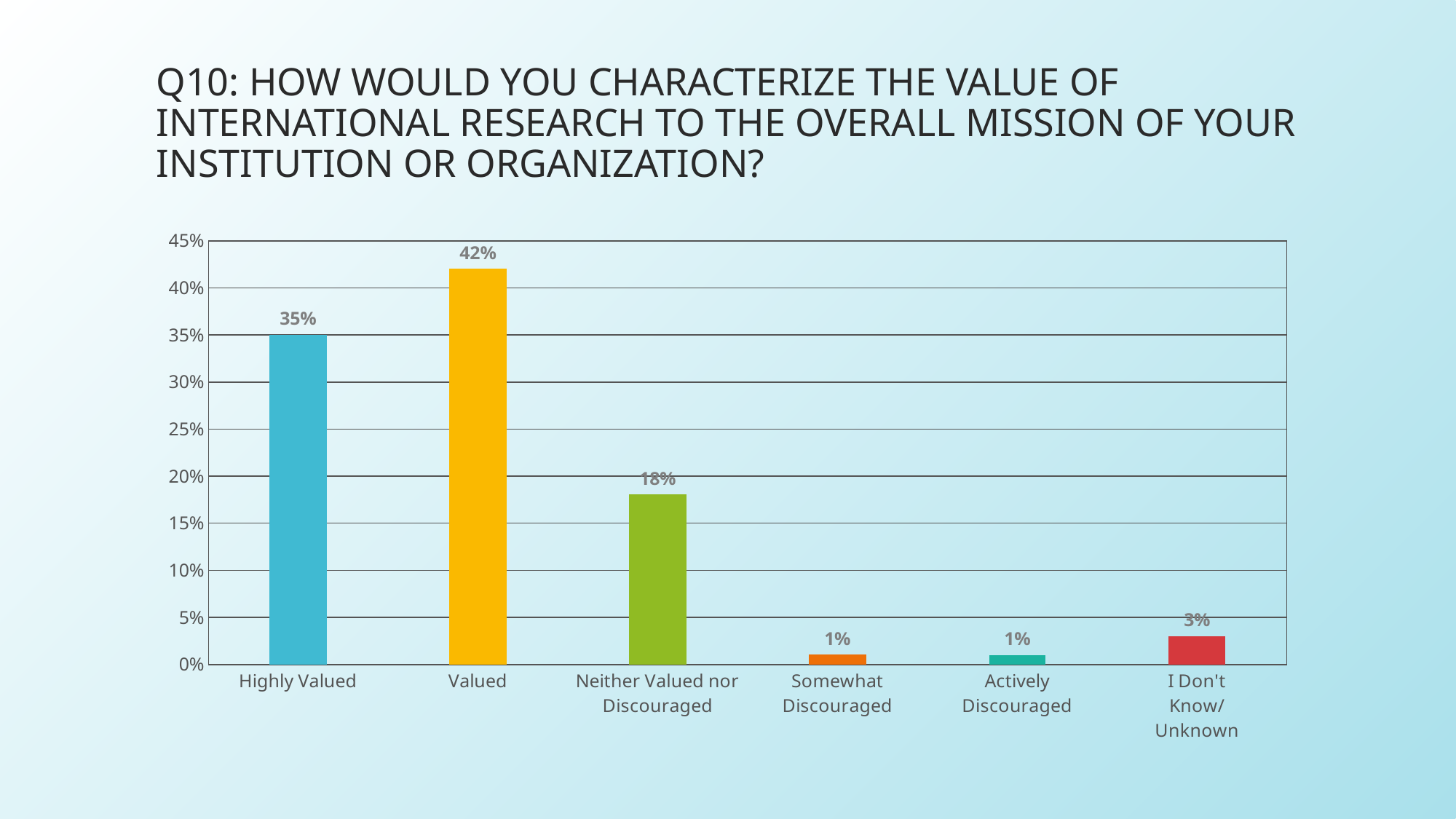
What is the combined percentage for "Somewhat Discouraged" and "Actively Discouraged"? 2% What colour is the bar for "Valued"? Yellow/orange What is the value for "I Don't Know/ Unknown"? 3% What is the difference between the "Valued" and "Highly Valued" percentages? 7% Which category has the highest value? Valued How many categories are shown on the x axis? 6 What percentage is shown for "Neither Valued nor Discouraged"? 18% What percentage of respondents said international research is "Highly Valued"? 35% Is the value for "Valued" greater or less than 40%? greater What kind of chart is shown on the slide? Bar chart What is the value shown for the "Valued" category? 42% Which is larger, the value for "Highly Valued" or for "Neither Valued nor Discouraged"? Highly Valued